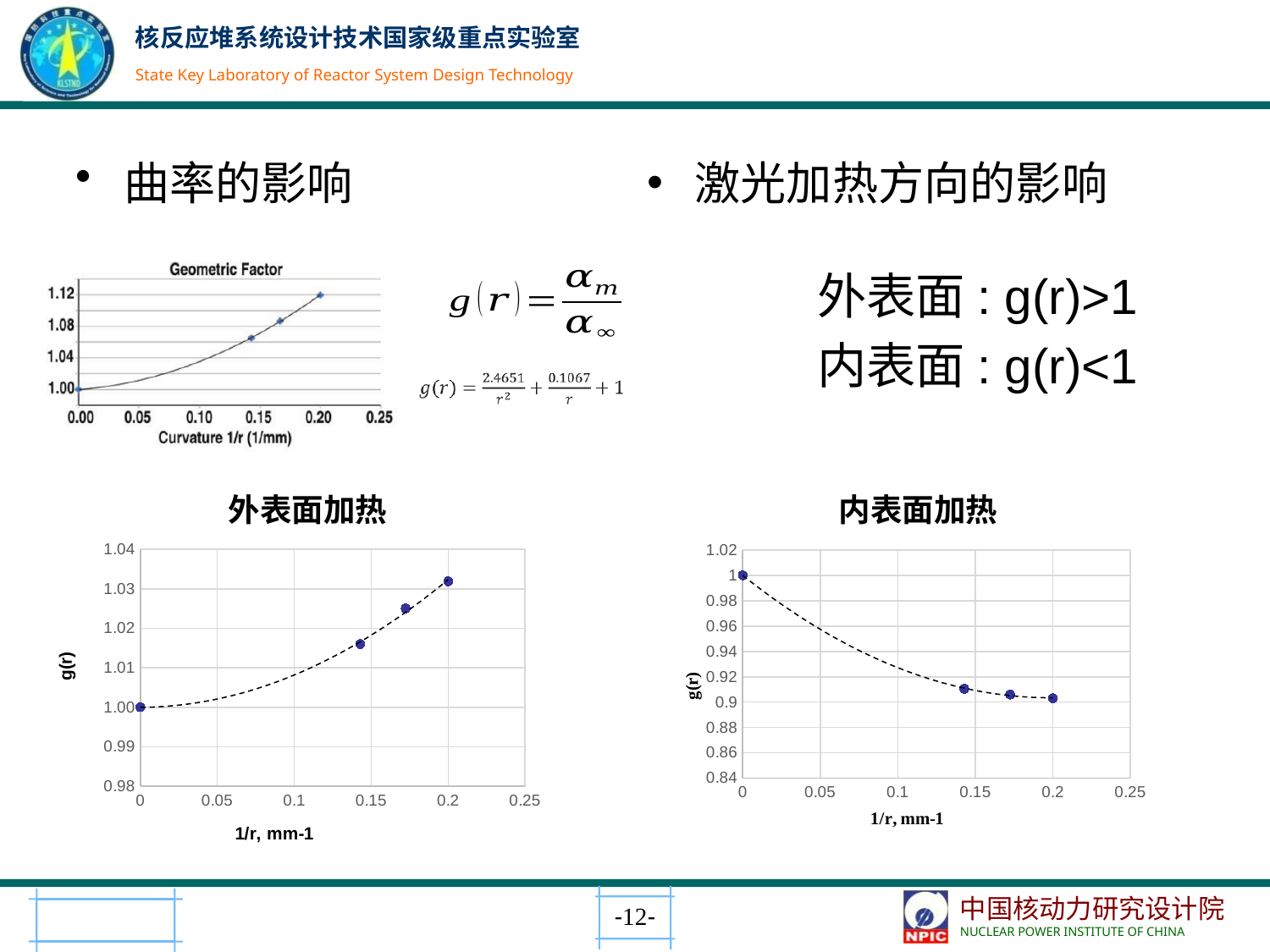
In the 外表面加热 chart, is the value of g(r) at 1/r = 0.2 greater or less than 1.02? greater In the 外表面加热 chart, what is the value of g(r) at 1/r = 0? 1.00 In the 内表面加热 chart, what is the value of g(r) at 1/r = 0? 1 In the 外表面加热 chart, at which 1/r value is g(r) highest? 0.2 In the 外表面加热 chart, does g(r) rise or fall as 1/r increases? rise In the 内表面加热 chart, does g(r) rise or fall as 1/r increases? fall What kind of chart is the 外表面加热 chart? scatter chart In the 内表面加热 chart, is the value of g(r) at 1/r = 0.2 greater or less than 0.92? less In the 内表面加热 chart, at which 1/r value is g(r) highest? 0 How many data points are plotted in the 外表面加热 chart? 4 How many data points are plotted in the 内表面加热 chart? 4 What is the x-axis title of the 内表面加热 chart? 1/r, mm-1